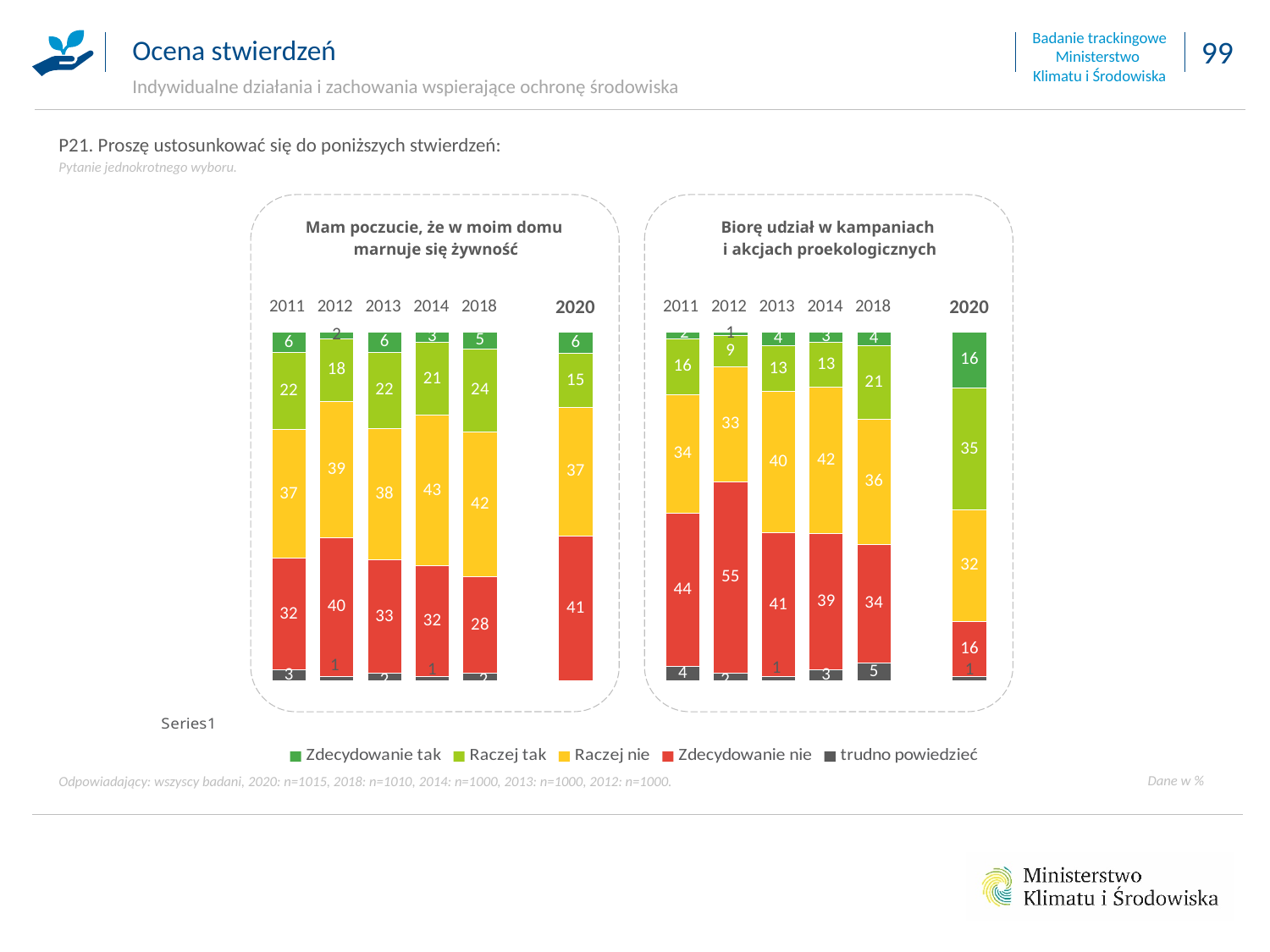
In the chart 'Biorę udział w kampaniach i akcjach proekologicznych', what is the difference between the 'Raczej tak' value in 2020 and in 2011? 19 What kind of chart is used on this slide? Stacked bar chart In the chart 'Biorę udział w kampaniach i akcjach proekologicznych', does the 'Zdecydowanie nie' value rise or fall from 2012 to 2020? Fall In the chart 'Biorę udział w kampaniach i akcjach proekologicznych', in which year is the 'Zdecydowanie nie' value highest? 2012 In the chart 'Biorę udział w kampaniach i akcjach proekologicznych', what is the total of the 2020 bar? 100 In the chart 'Biorę udział w kampaniach i akcjach proekologicznych', in which year is the 'Raczej tak' value lowest? 2012 How many series does the legend list? 5 In the chart 'Mam poczucie, że w moim domu marnuje się żywność', which is larger: the 'Raczej nie' value in 2014 or in 2018? 2014 How many years are shown on the x axis of the chart 'Biorę udział w kampaniach i akcjach proekologicznych'? 6 In the chart 'Biorę udział w kampaniach i akcjach proekologicznych', what is the value for 'Raczej tak' in 2020? 35 Which colour represents 'Raczej nie' in the legend? Yellow In the chart 'Mam poczucie, że w moim domu marnuje się żywność', what is the value for 'Zdecydowanie nie' in 2020? 41